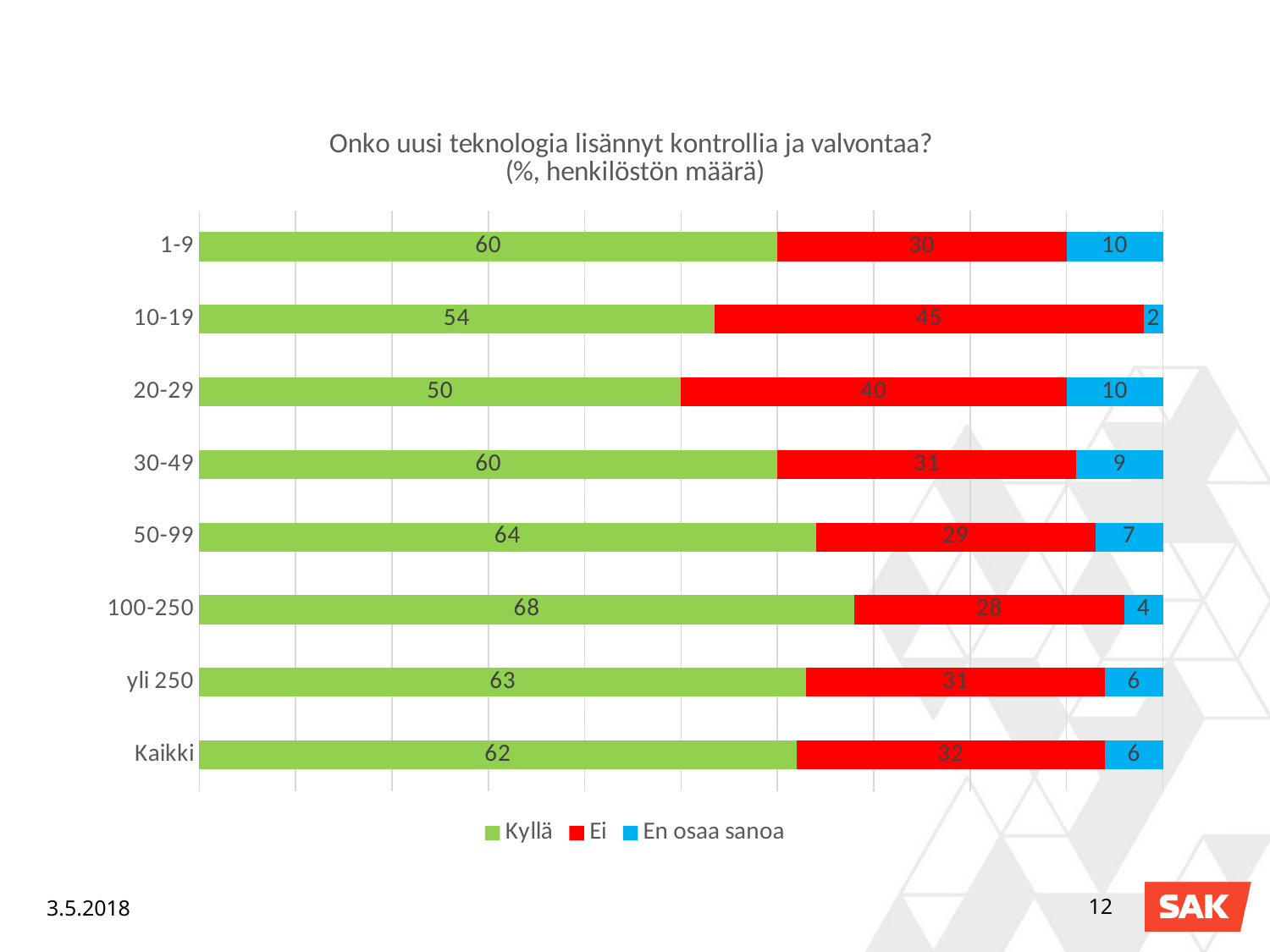
How many series does the legend list? 3 What is the value of Kyllä for the 100-250 category? 68 What kind of chart is shown on the slide? Stacked bar chart What is the value of En osaa sanoa for the 50-99 category? 7 Which category has the highest Kyllä value? 100-250 How many categories are shown on the y axis? 8 What is the value of Ei for the 10-19 category? 45 What is the difference between the Ei values for 10-19 and 100-250? 17 What is the total of the stacked bar for the Kaikki category? 100 Which category has the lowest Kyllä value? 20-29 Which colour represents the Ei series in the legend? Red Which is larger, the Kyllä value for 50-99 or for yli 250? 50-99